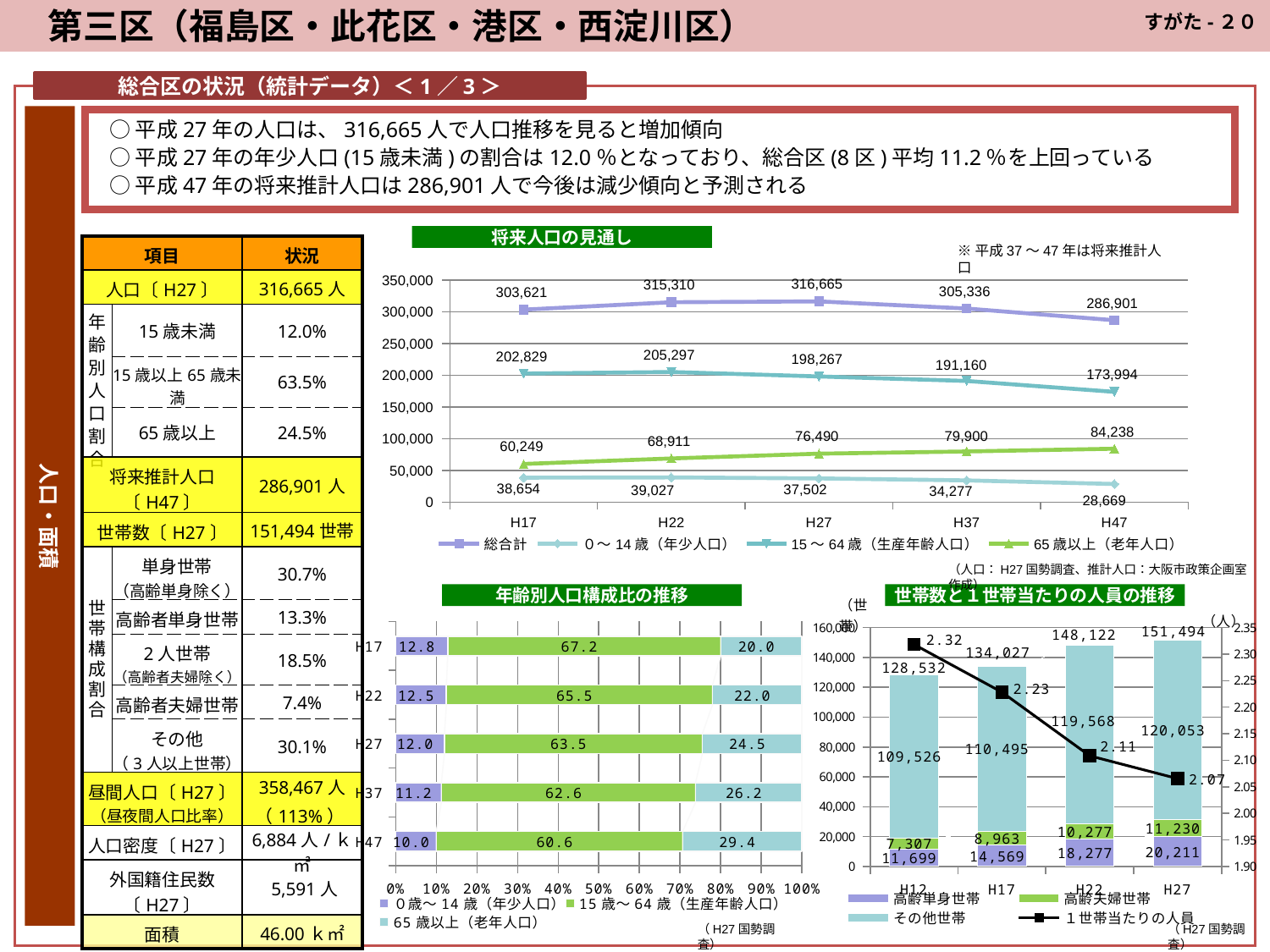
In the 将来人口の見通し chart, how many series does the legend list? 4 In the 将来人口の見通し chart, what is the 15～64歳（生産年齢人口） value for H37? 191,160 In the 世帯数と1世帯当たりの人員の推移 chart, what is the total number of households for H22? 148,122 In the 将来人口の見通し chart, does the 0～14歳（年少人口） series rise or fall from H22 to H47? fall What kind of chart is the 年齢別人口構成比の推移 chart? stacked bar chart In the 年齢別人口構成比の推移 chart, which year has the lowest 0歳～14歳（年少人口） share? H47 In the 世帯数と1世帯当たりの人員の推移 chart, which is larger for H17: 高齢単身世帯 or 高齢夫婦世帯? 高齢単身世帯 In the 世帯数と1世帯当たりの人員の推移 chart, what is the 1世帯当たりの人員 value for H27? 2.07 In the 将来人口の見通し chart, which year has the highest 総合計 value? H27 In the 年齢別人口構成比の推移 chart, what is the 65歳以上（老年人口） share for H47? 29.4 In the 将来人口の見通し chart, what is the difference between the 65歳以上（老年人口） values for H47 and H17? 23,989 In the 将来人口の見通し chart, what is the 総合計 value for H27? 316,665